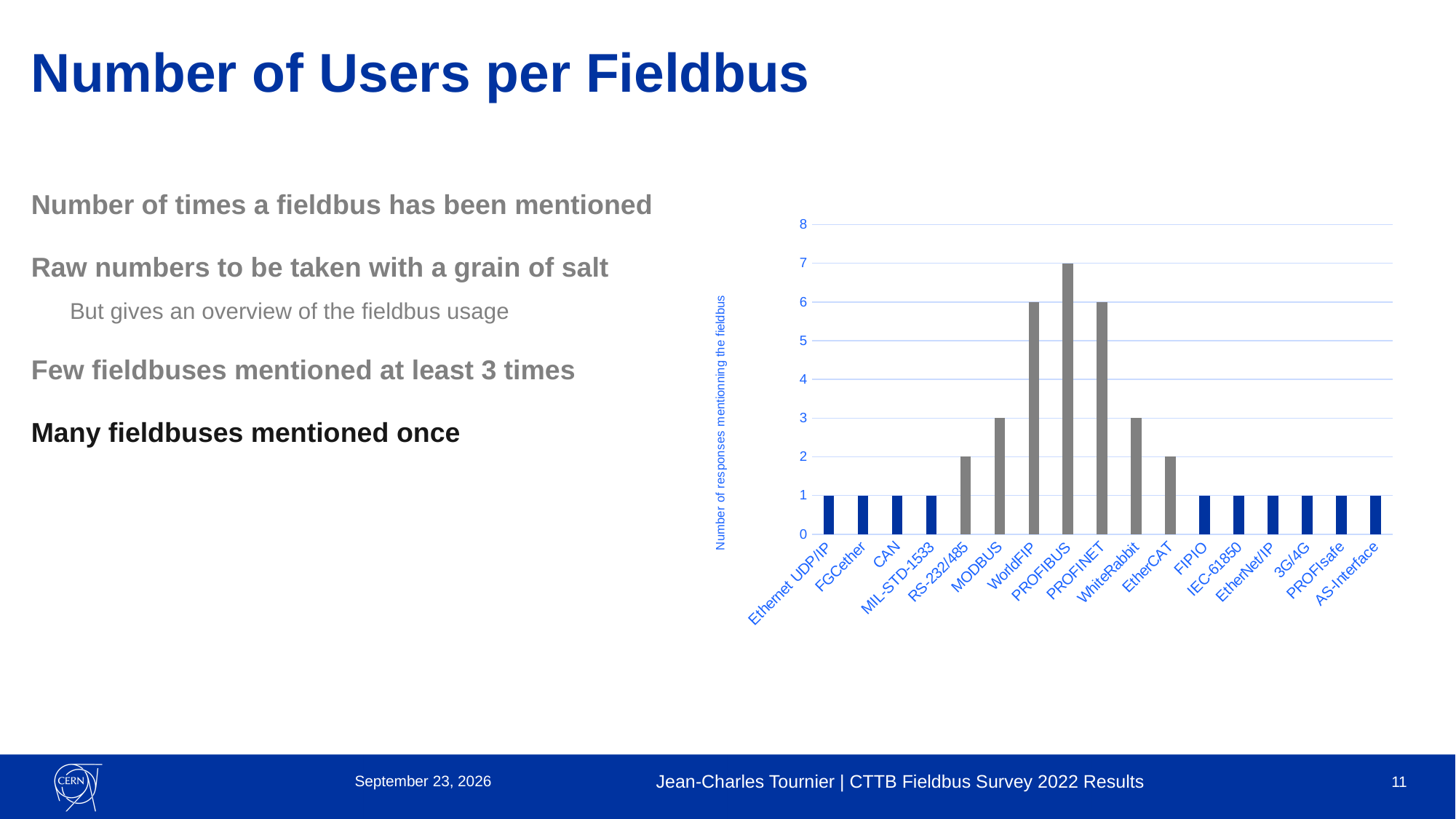
Which has more responses, WhiteRabbit or RS-232/485? WhiteRabbit How many responses mention WorldFIP? 6 What is the difference between the number of responses for PROFIBUS and for PROFINET? 1 How many responses mention EtherCAT? 2 What is the label of the vertical axis of the chart? Number of responses mentionning the fieldbus Which fieldbus has the highest number of responses mentioning it? PROFIBUS Is the value for PROFINET greater or less than 4? greater What kind of chart is shown on the slide? bar chart How many fieldbuses are shown on the x axis of the chart? 17 What is the highest value shown on the vertical axis of the chart? 8 How many responses mention PROFIBUS? 7 How many responses mention MODBUS? 3